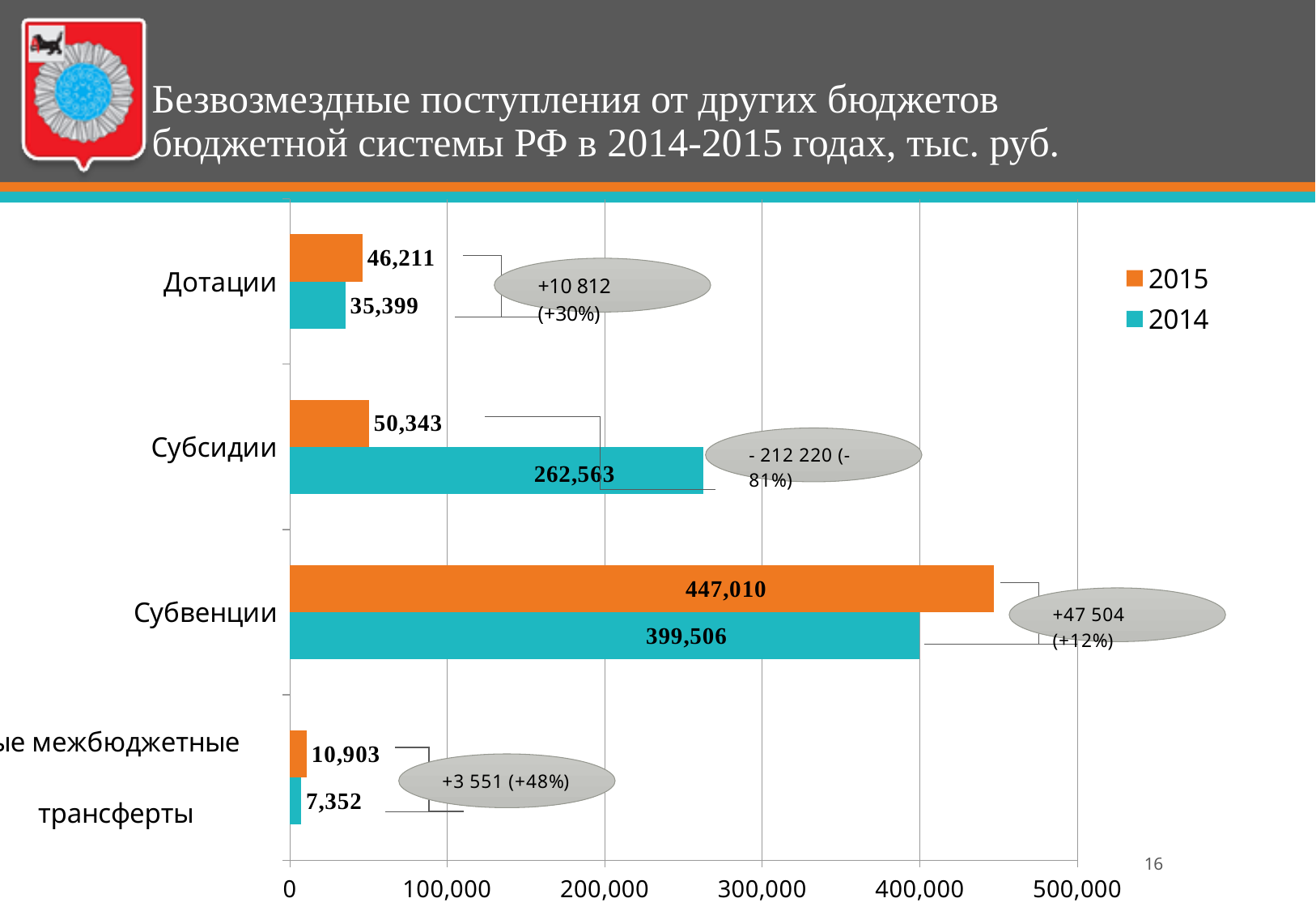
Which category has the highest 2014 value? Субвенции For Субсидии, which year has the larger value, 2015 or 2014? 2014 What is the 2014 value for Субсидии? 262,563 What is the difference between the 2015 and 2014 values for Субвенции? 47,504 What is the 2015 value for Дотации? 46,211 What is the 2015 value for Субвенции? 447,010 How many series does the legend list? 2 What is the difference between the 2015 and 2014 values for Дотации? 10,812 What is the 2014 value for Субвенции? 399,506 What kind of chart is shown on the slide? bar chart Among Дотации, Субсидии and Субвенции, which has the lowest 2015 value? Дотации Is the 2014 value for Субсидии greater or less than 200,000? greater